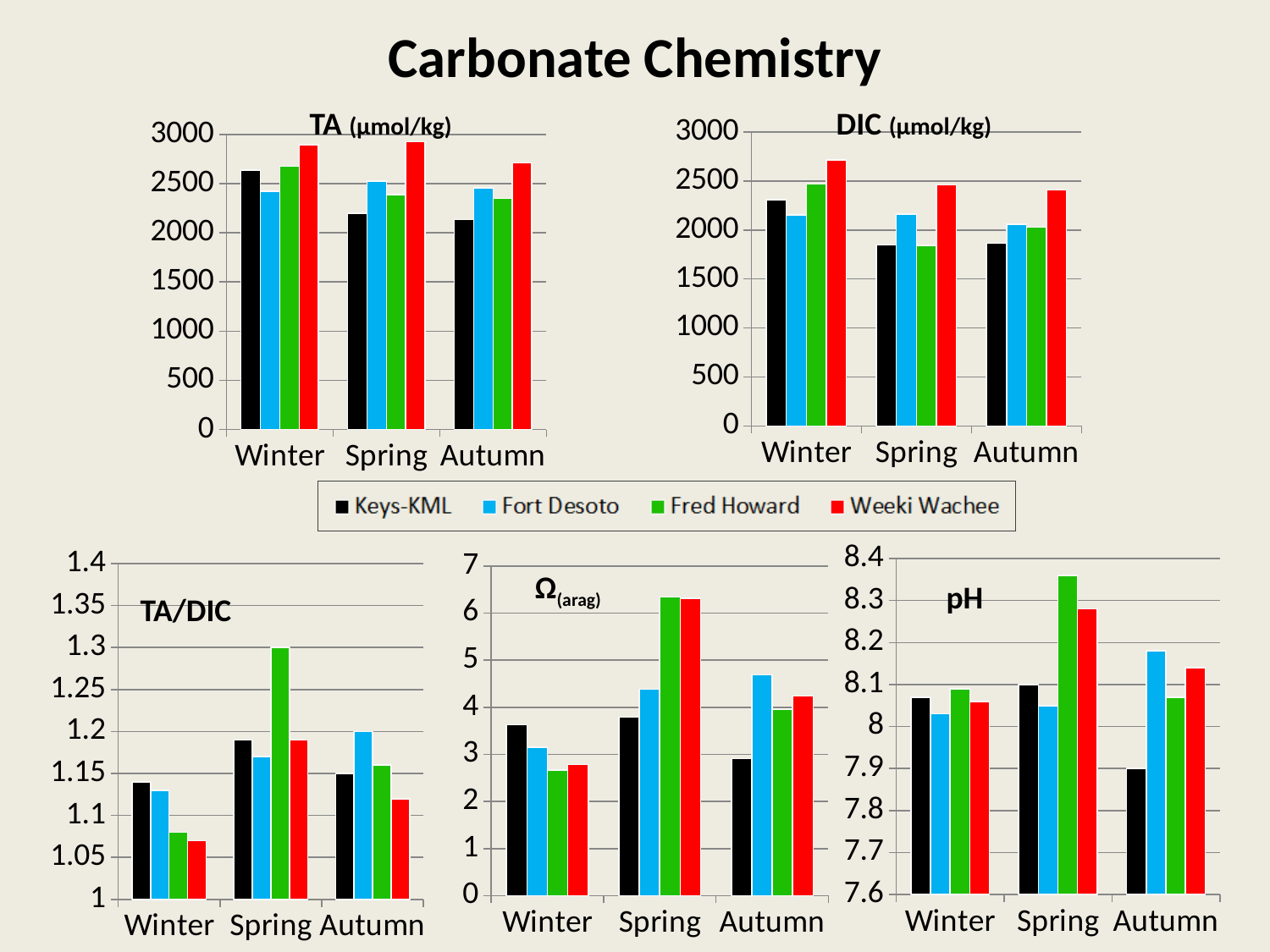
In the DIC (μmol/kg) chart, which site has the highest DIC in Winter? Weeki Wachee What kind of chart is the TA/DIC chart? bar chart In the TA (μmol/kg) chart, which site has the highest TA in Spring? Weeki Wachee In the Ω(arag) chart, is the Keys-KML value larger in Winter or in Autumn? Winter In the TA (μmol/kg) chart, is the Winter value for Keys-KML greater or less than 2500? greater How many series does the shared legend list? 4 In the pH chart, which site has the lowest pH in Autumn? Keys-KML How many seasons are shown on the x axis of the pH chart? 3 In the pH chart, is the Autumn value for Keys-KML greater or less than 8? less In the TA/DIC chart, which site has the highest TA/DIC in Spring? Fred Howard In the DIC (μmol/kg) chart, is the Spring value for Fort Desoto greater or less than 2000? greater